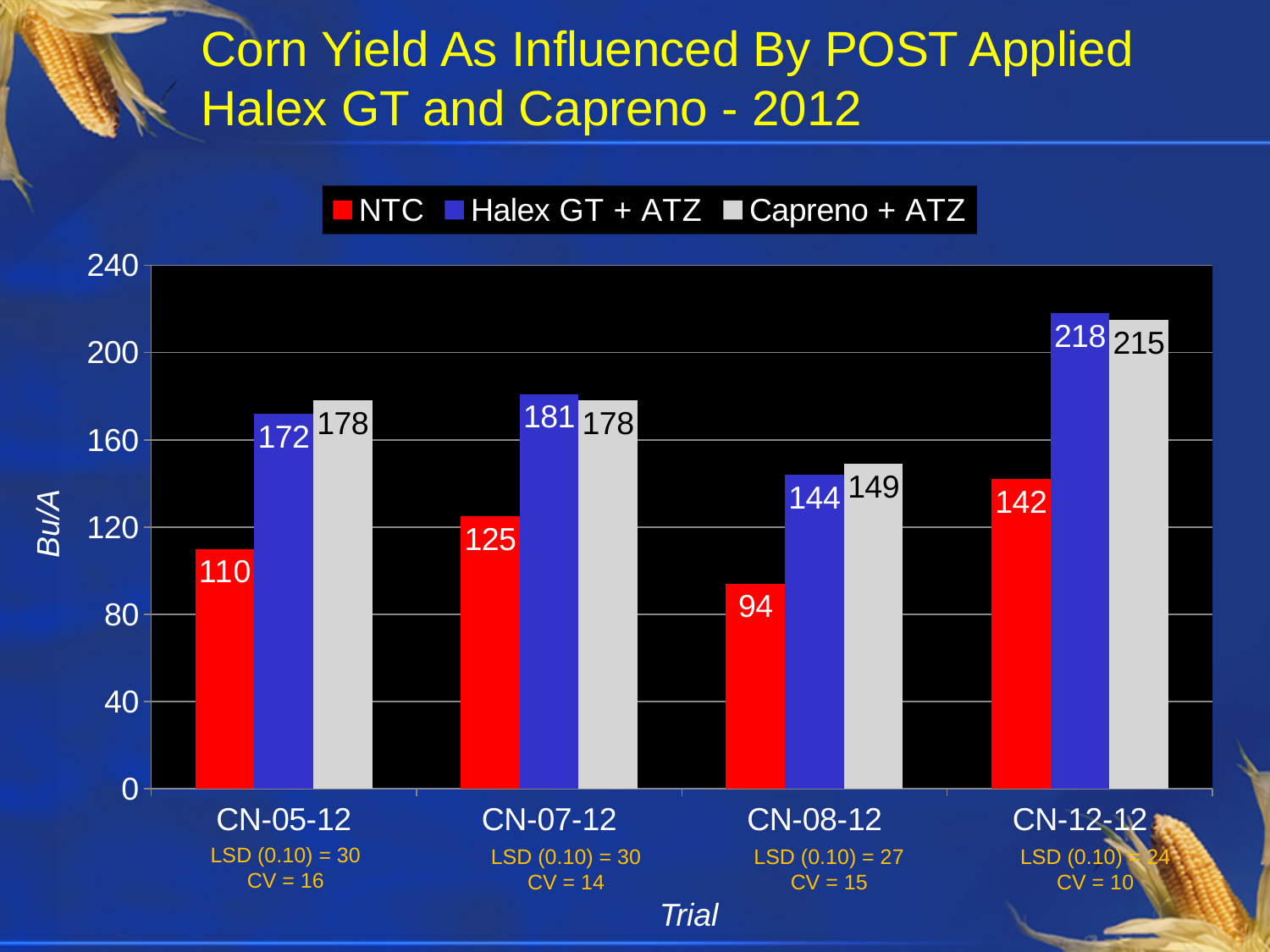
In trial CN-05-12, which is larger: the Halex GT + ATZ yield or the Capreno + ATZ yield? Capreno + ATZ What is the Halex GT + ATZ yield for trial CN-12-12? 218 Which trial has the highest Capreno + ATZ yield? CN-12-12 Which trial has the lowest NTC yield? CN-08-12 Is the NTC yield for trial CN-12-12 greater or less than 120? greater What is the label of the y axis? Bu/A How many trials are shown on the x axis? 4 What is the difference between the Halex GT + ATZ and NTC yields in trial CN-07-12? 56 What is the Capreno + ATZ yield for trial CN-08-12? 149 What is the NTC yield for trial CN-05-12? 110 How many series does the legend list? 3 What kind of chart is shown on the slide? bar chart